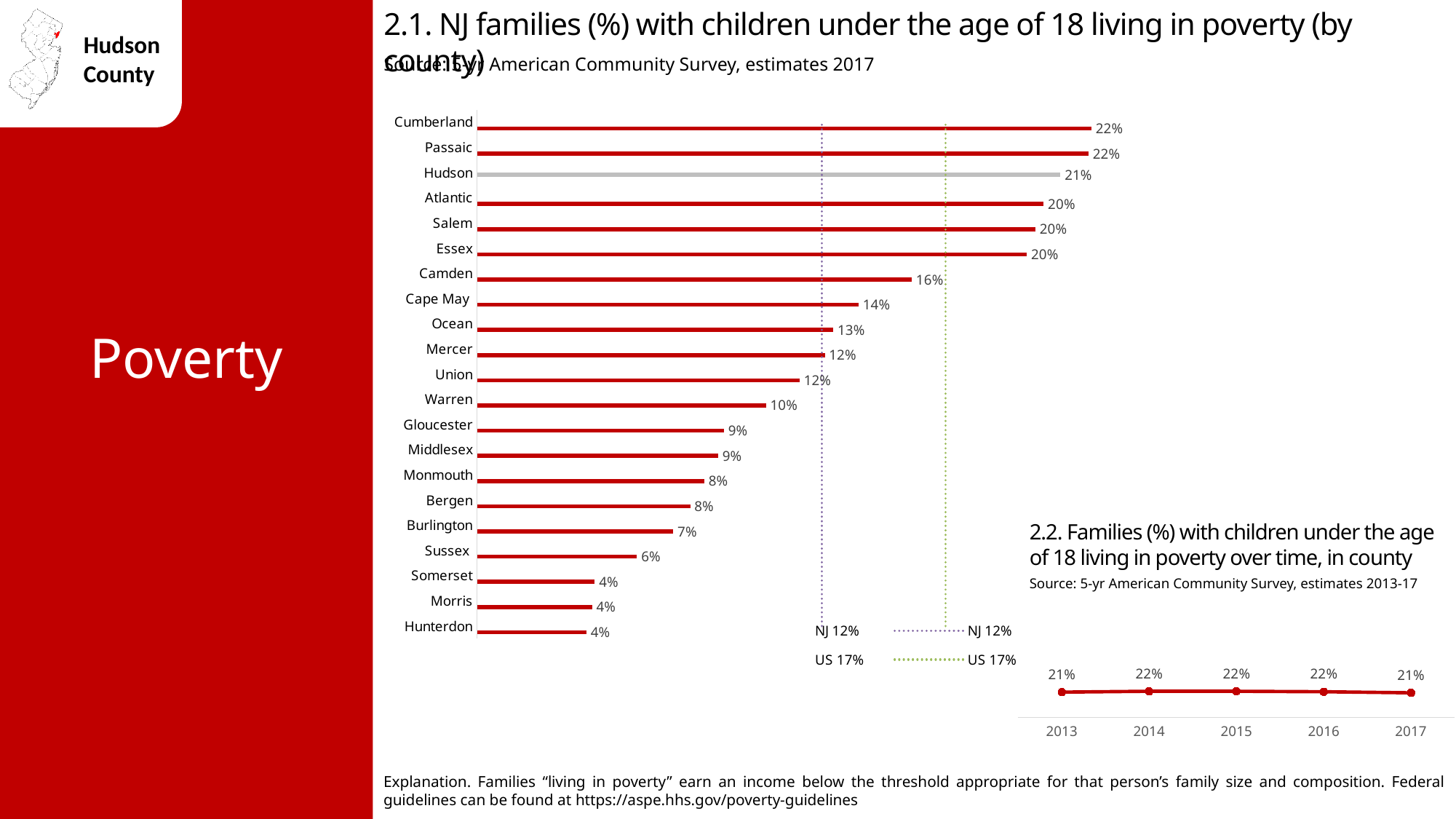
In chart 2.1 (by county), how many counties are shown? 21 In chart 2.1 (by county), what is the value for Cape May? 14% In chart 2.1 (by county), what is the difference between the values for Hudson and Bergen? 13% In chart 2.1 (by county), what NJ value is marked by the dotted reference line? 12% What kind of chart is chart 2.1 (by county)? Bar chart In chart 2.2 (over time, in county), how many years are plotted? 5 In chart 2.2 (over time, in county), what is the difference between the values for 2014 and 2017? 1% In chart 2.1 (by county), what US value is marked by the dotted reference line? 17% In chart 2.2 (families in poverty over time, in county), what is the value for 2015? 22% In chart 2.1 (NJ families with children under 18 living in poverty by county), what is the value for Hudson? 21% In chart 2.1 (by county), what is the value for Camden? 16% In chart 2.1 (by county), which has the larger value, Ocean or Warren? Ocean